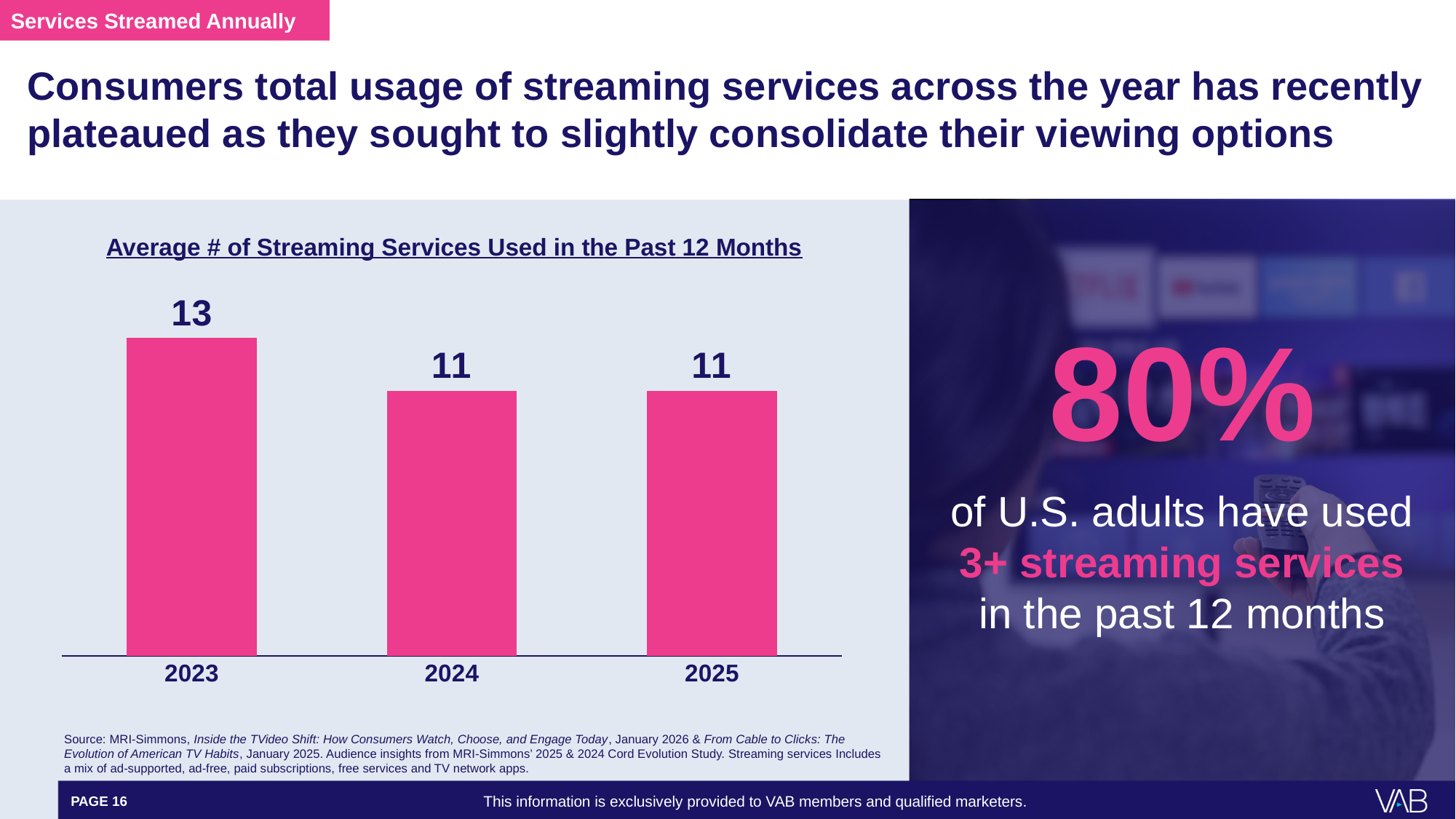
Which is larger, the value for 2023 or the value for 2025? 2023 What kind of chart is shown on the slide? Bar chart What is the difference between the 2023 and 2024 values in the chart? 2 How many years are shown in the chart? 3 What colour are the bars in the chart? Pink What is the title of the chart? Average # of Streaming Services Used in the Past 12 Months Which year has the highest average number of streaming services used? 2023 What is the average number of streaming services used in the past 12 months for 2025? 11 Does the value change between 2024 and 2025? No, it stays at 11 What is the average number of streaming services used in the past 12 months for 2024? 11 What is the average number of streaming services used in the past 12 months for 2023? 13 Do the values in the chart rise or fall from 2023 to 2024? Fall